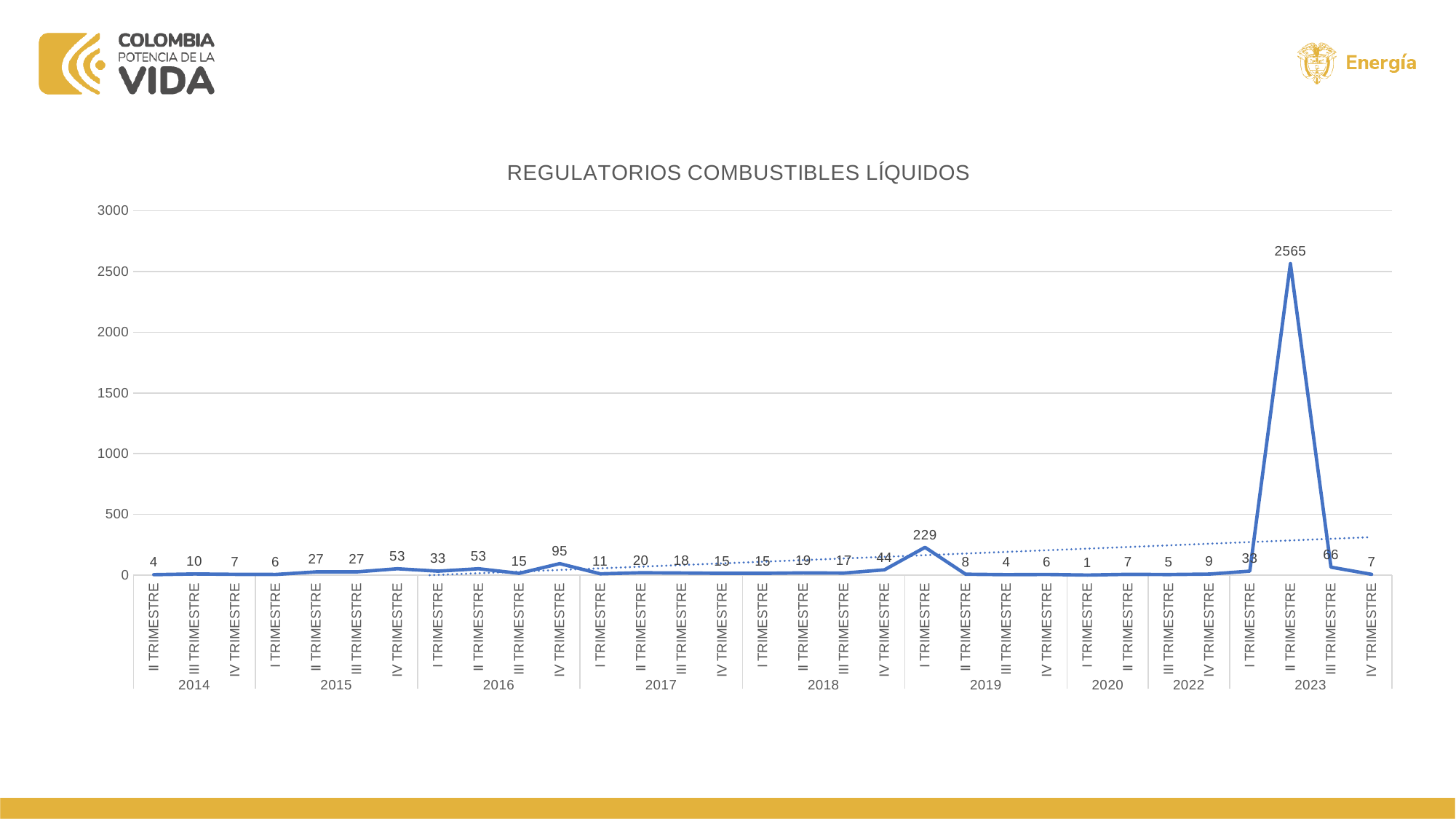
What is the value for III TRIMESTRE 2023? 66 How many data points are plotted on the line? 31 Which quarter has the lowest value? I TRIMESTRE 2020 What kind of chart is shown on the slide? Line chart What is the value for II TRIMESTRE 2023? 2565 What is the difference between the values for II TRIMESTRE 2023 and I TRIMESTRE 2019? 2336 What is the title of the chart? REGULATORIOS COMBUSTIBLES LÍQUIDOS Which is larger, the value for IV TRIMESTRE 2016 or the value for IV TRIMESTRE 2018? IV TRIMESTRE 2016 Which quarter has the highest value? II TRIMESTRE 2023 What is the value for I TRIMESTRE 2019? 229 What is the value for IV TRIMESTRE 2016? 95 Is the value for II TRIMESTRE 2023 greater or less than 2500? greater